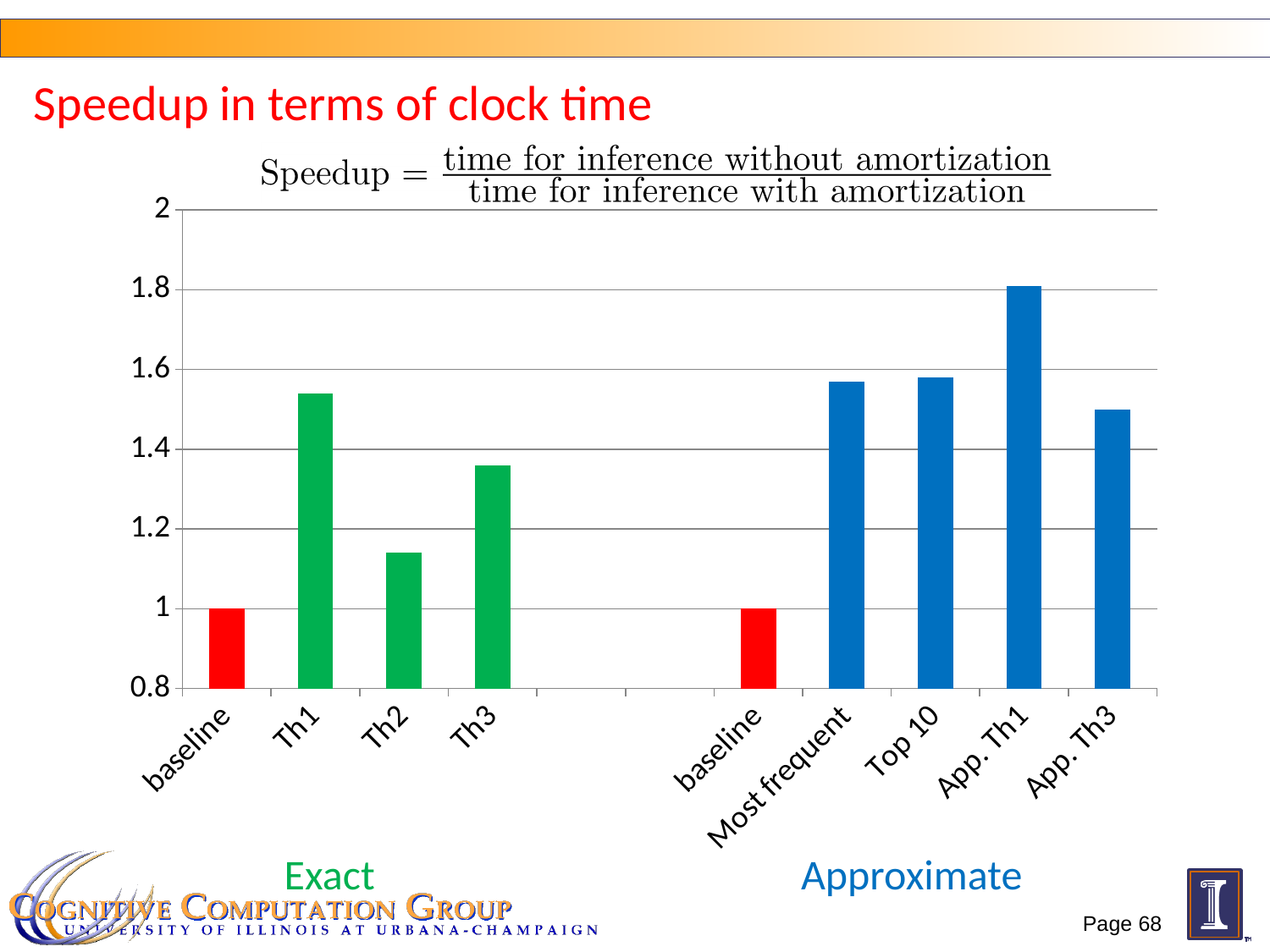
Is the value for App. Th1 greater or less than 1.6? greater Is the value for Th1 greater or less than 1.4? greater What colour are the baseline bars? red What is the speedup value for the baseline bars? 1 What type of chart is shown on the slide? bar chart Which has a larger speedup, Th1 or Th2? Th1 Among the Exact bars Th1, Th2 and Th3, which has the lowest speedup? Th2 How many bars are plotted in the chart? 9 Which has a larger speedup, App. Th1 or App. Th3? App. Th1 Is the value for Th2 greater or less than 1.2? less Which bar has the highest speedup? App. Th1 What is the title of the chart? Speedup in terms of clock time